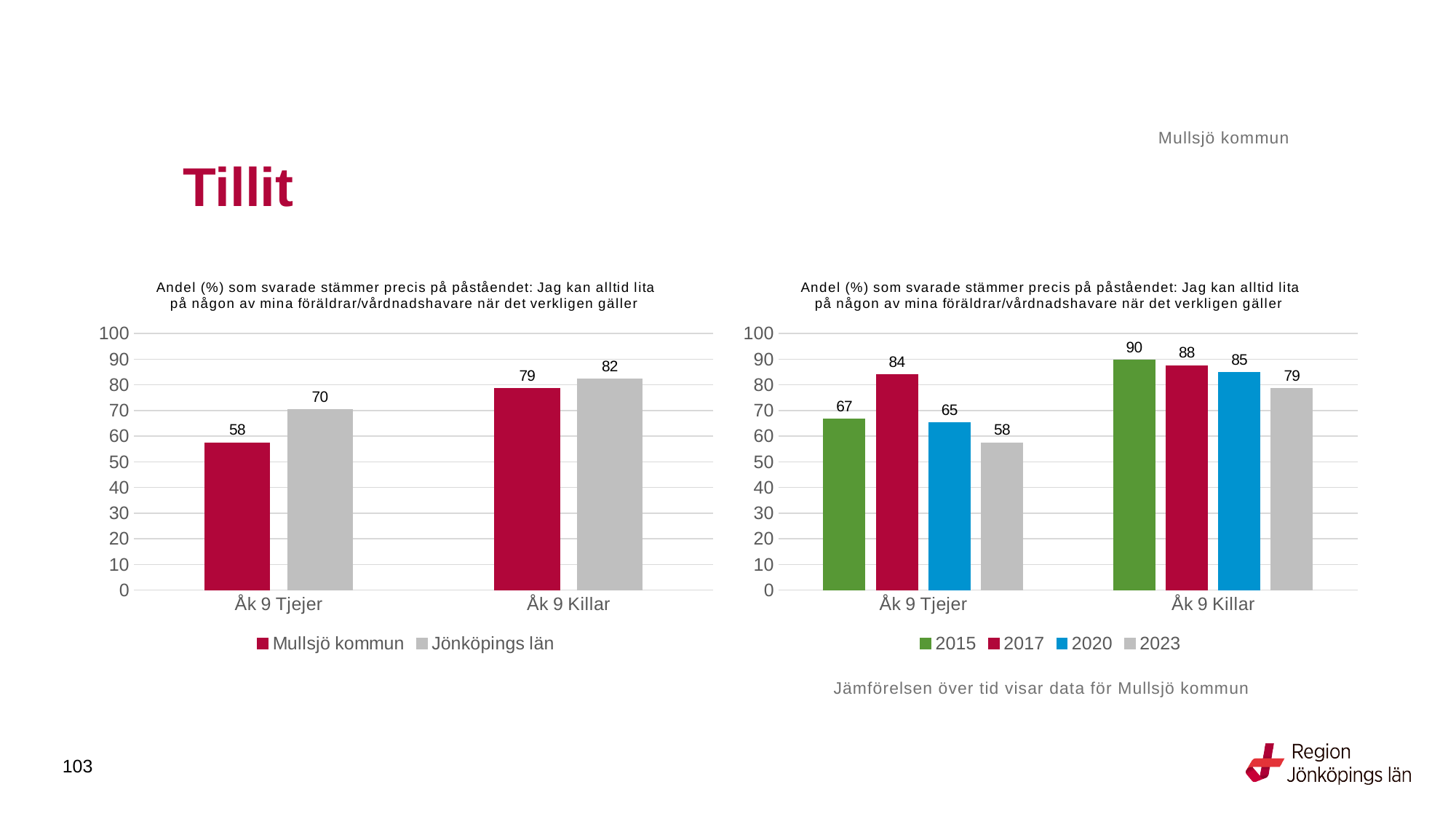
In the left chart, what is the value for Mullsjö kommun for Åk 9 Tjejer? 58 How many series does the legend of the left chart list? 2 In the right chart, which year has the highest value for Åk 9 Killar? 2015 In the right chart, which year has the lowest value for Åk 9 Tjejer? 2023 In the left chart, which is larger for Åk 9 Killar: Mullsjö kommun or Jönköpings län? Jönköpings län In the right chart, what is the difference between the 2015 values for Åk 9 Killar and Åk 9 Tjejer? 23 In the left chart, what is the value for Jönköpings län for Åk 9 Killar? 82 In the left chart, what is the difference between Jönköpings län and Mullsjö kommun for Åk 9 Tjejer? 12 How many series does the legend of the right chart list? 4 In the right chart, what is the value for 2023 for Åk 9 Killar? 79 What type of chart is the right chart? Bar chart In the right chart, what is the value for 2017 for Åk 9 Tjejer? 84